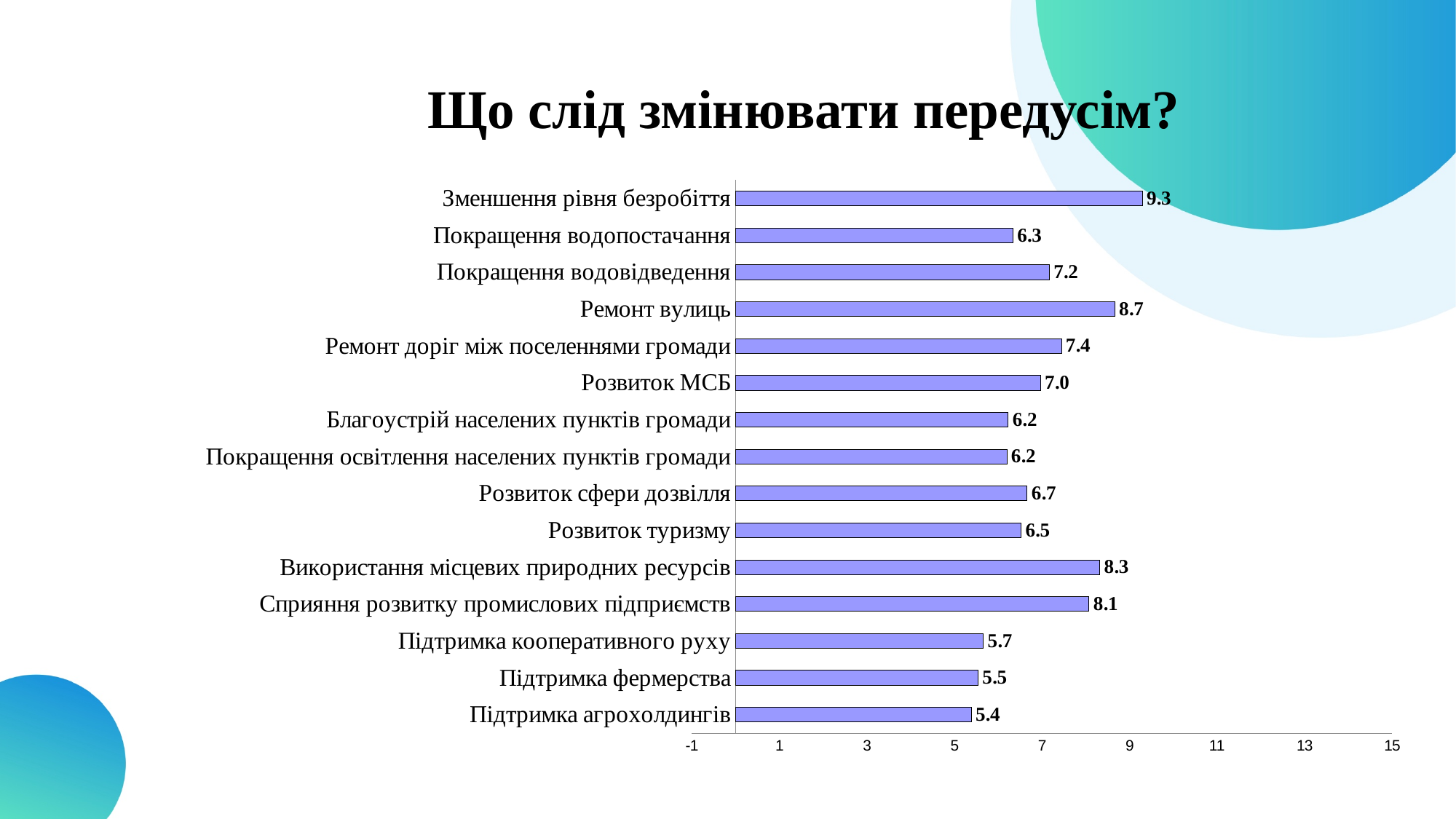
What kind of chart is shown on the slide? bar chart What is the title of the slide? Що слід змінювати передусім? Is the value for Використання місцевих природних ресурсів greater or less than 7? greater Which category has the highest value? Зменшення рівня безробіття What is the value for Ремонт вулиць? 8.7 What is the value for Підтримка фермерства? 5.5 Which is larger, the value for Розвиток туризму or the value for Розвиток сфери дозвілля? Розвиток сфери дозвілля What is the value for Зменшення рівня безробіття? 9.3 How many categories are shown in the chart? 15 What is the difference between the values for Покращення водовідведення and Покращення водопостачання? 0.9 Which category has the lowest value? Підтримка агрохолдингів What is the difference between the values for Зменшення рівня безробіття and Підтримка агрохолдингів? 3.9